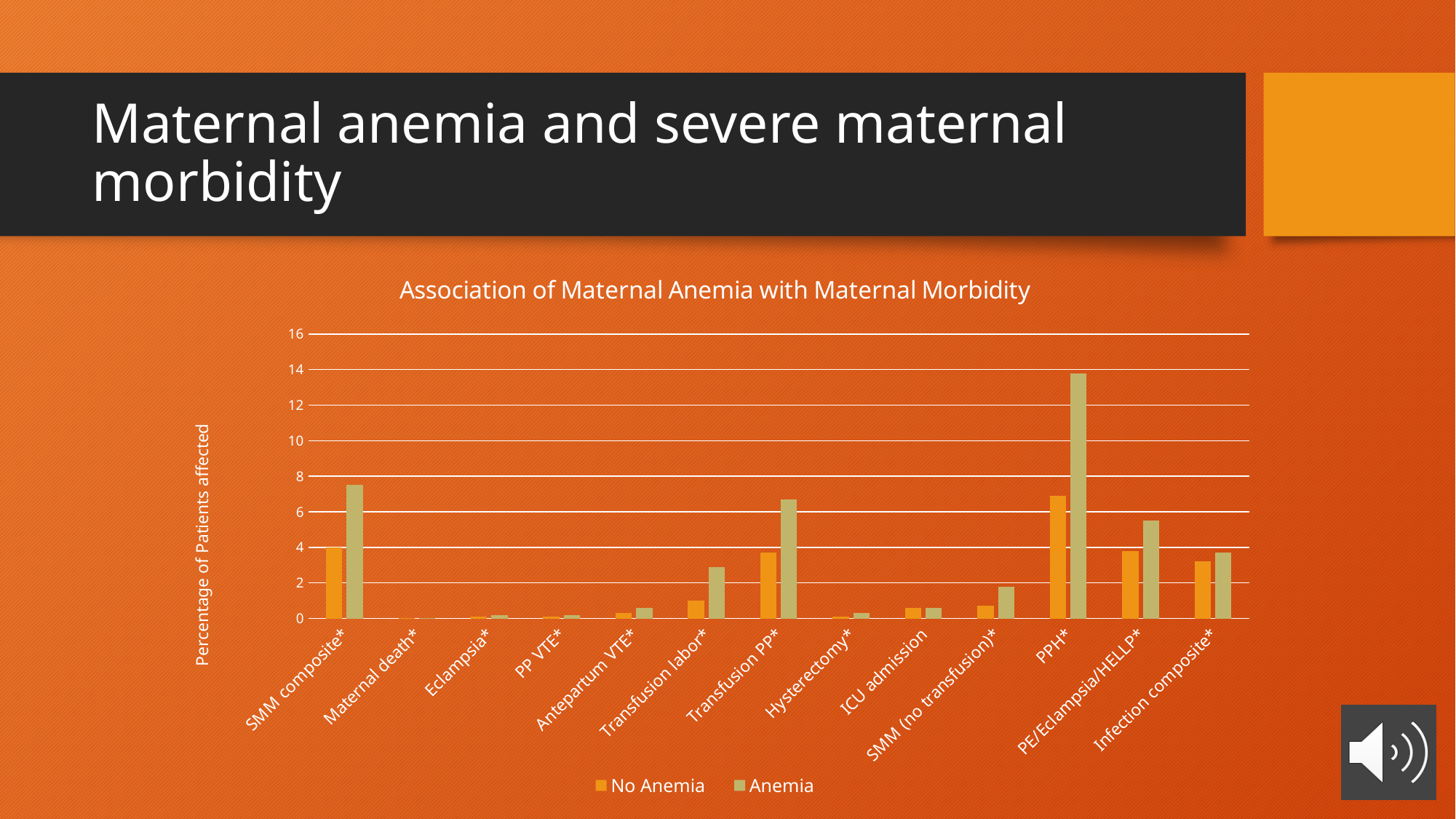
What type of chart is shown on the slide? bar chart Is the Anemia value for PE/Eclampsia/HELLP* greater or less than 6? less Is the Anemia value for SMM composite* greater or less than 6? greater For SMM composite*, which series has the larger value, No Anemia or Anemia? Anemia What is the title of the chart? Association of Maternal Anemia with Maternal Morbidity How many series does the legend list? 2 What is the label of the y axis? Percentage of Patients affected How many categories are shown on the x axis? 13 Which category has the highest value for the Anemia series? PPH* Which category has the highest value for the No Anemia series? PPH* Is the Anemia value for PPH* greater or less than 12? greater